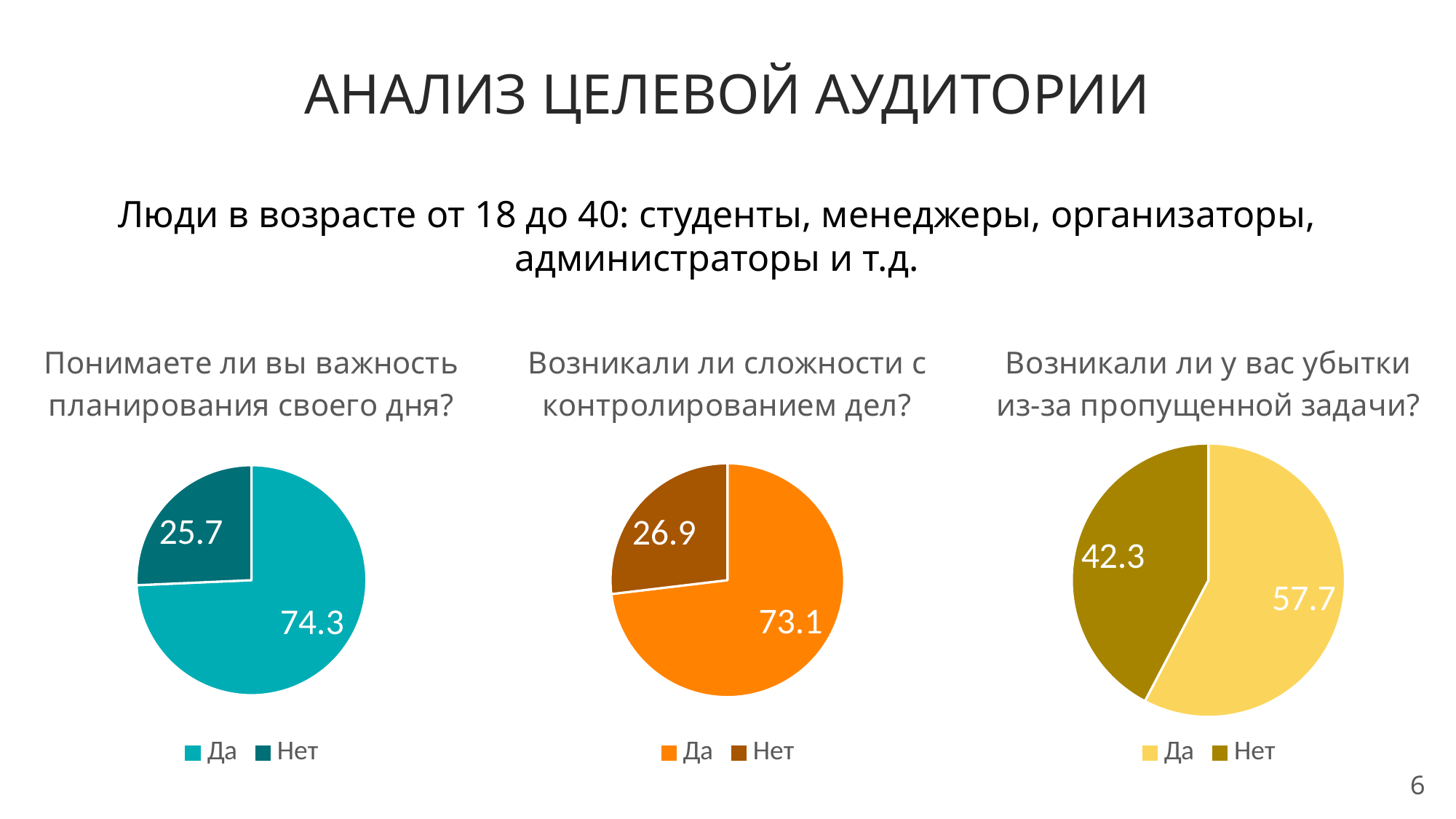
What type of chart is the middle chart 'Возникали ли сложности с контролированием дел?'? Pie chart In the right chart 'Возникали ли у вас убытки из-за пропущенной задачи?', what is the difference between the 'Да' and 'Нет' values? 15.4 In the right chart 'Возникали ли у вас убытки из-за пропущенной задачи?', what is the value for 'Да'? 57.7 In the left chart 'Понимаете ли вы важность планирования своего дня?', what is the difference between the 'Да' and 'Нет' values? 48.6 In the right chart 'Возникали ли у вас убытки из-за пропущенной задачи?', what is the value for 'Нет'? 42.3 How many slices does the left chart 'Понимаете ли вы важность планирования своего дня?' have? 2 How many entries does the legend of the right chart 'Возникали ли у вас убытки из-за пропущенной задачи?' list? 2 In the left chart 'Понимаете ли вы важность планирования своего дня?', what is the value for 'Да'? 74.3 In the middle chart 'Возникали ли сложности с контролированием дел?', what is the value for 'Да'? 73.1 In the middle chart 'Возникали ли сложности с контролированием дел?', what is the value for 'Нет'? 26.9 In the left chart 'Понимаете ли вы важность планирования своего дня?', what is the value for 'Нет'? 25.7 In the right chart 'Возникали ли у вас убытки из-за пропущенной задачи?', which slice is larger, 'Да' or 'Нет'? Да